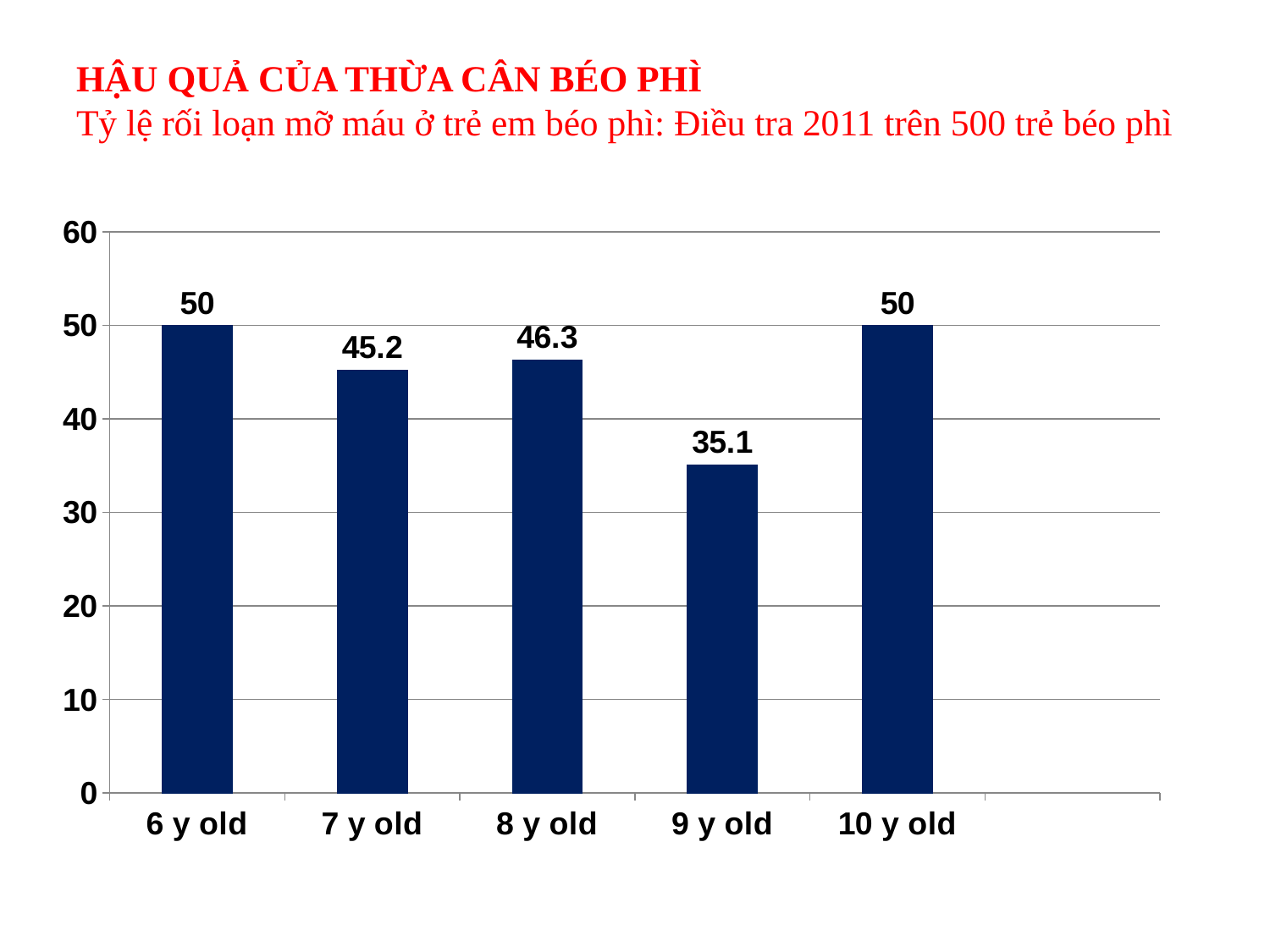
What is the value for 6 y old? 50 What is the difference between the values for 8 y old and 9 y old? 11.2 What is the value for 9 y old? 35.1 Which age group has the lowest value? 9 y old How many age groups are shown on the x axis? 5 What is the difference between the values for 6 y old and 7 y old? 4.8 What is the value for 7 y old? 45.2 Is the value for 9 y old greater or less than 40? less What kind of chart is shown on the slide? bar chart Which is larger, the value for 7 y old or the value for 9 y old? 7 y old What is the highest value shown on the y axis? 60 What is the value for 8 y old? 46.3